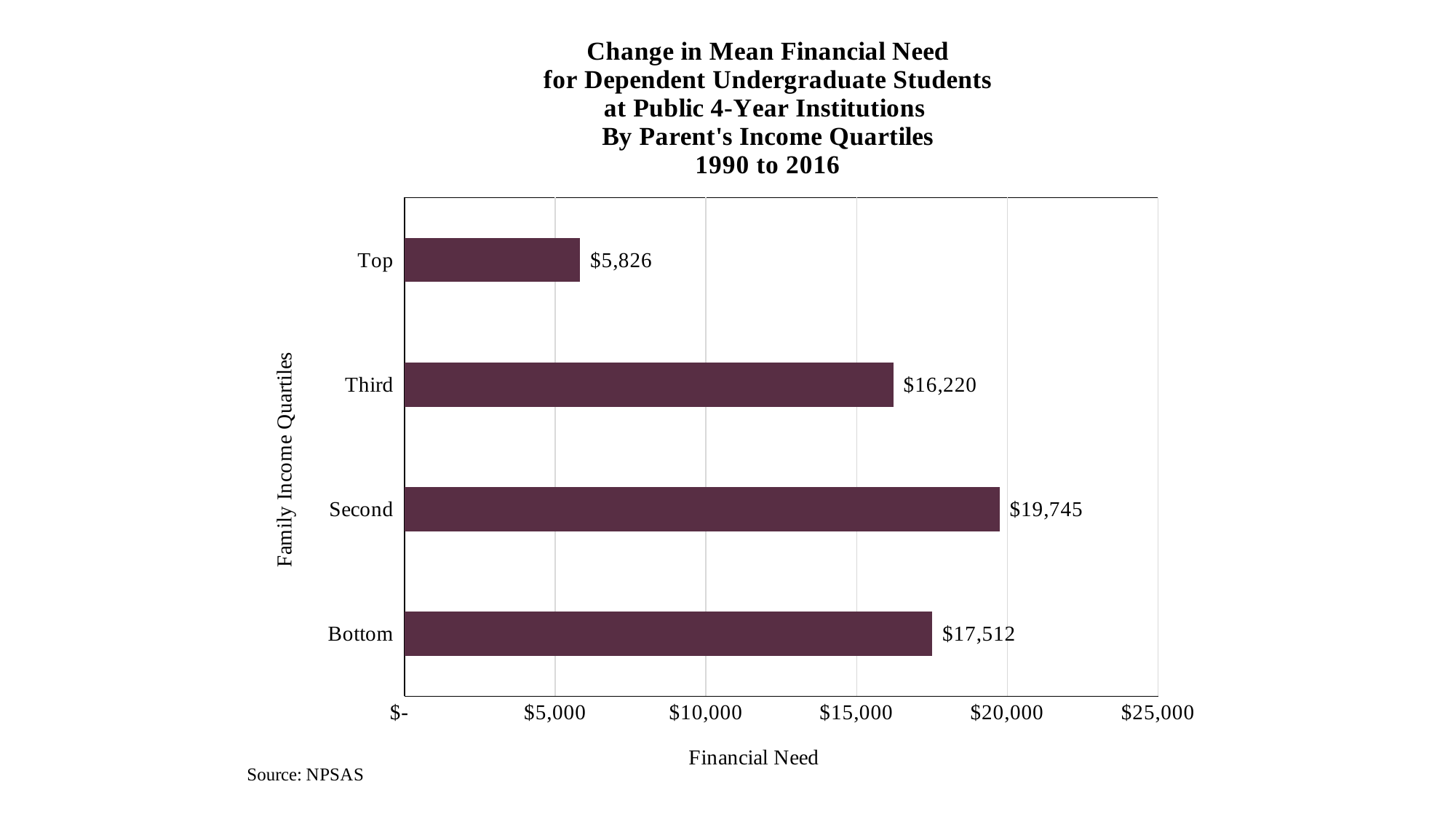
Which has a larger value, the Bottom quartile or the Third quartile? Bottom How many income quartiles are shown on the chart? 4 Which income quartile has the highest change in mean financial need? Second What is the difference between the values for the Bottom and Top quartiles? $11,686 What is the value shown for the Bottom income quartile? $17,512 Which income quartile has the lowest change in mean financial need? Top What is the source cited for the chart data? NPSAS What is the change in mean financial need for the Second income quartile? $19,745 Is the value for the Third quartile greater or less than $15,000? greater What is the difference between the values for the Second and Third quartiles? $3,525 What is the change in mean financial need for the Top income quartile? $5,826 What kind of chart is shown on the slide? Bar chart